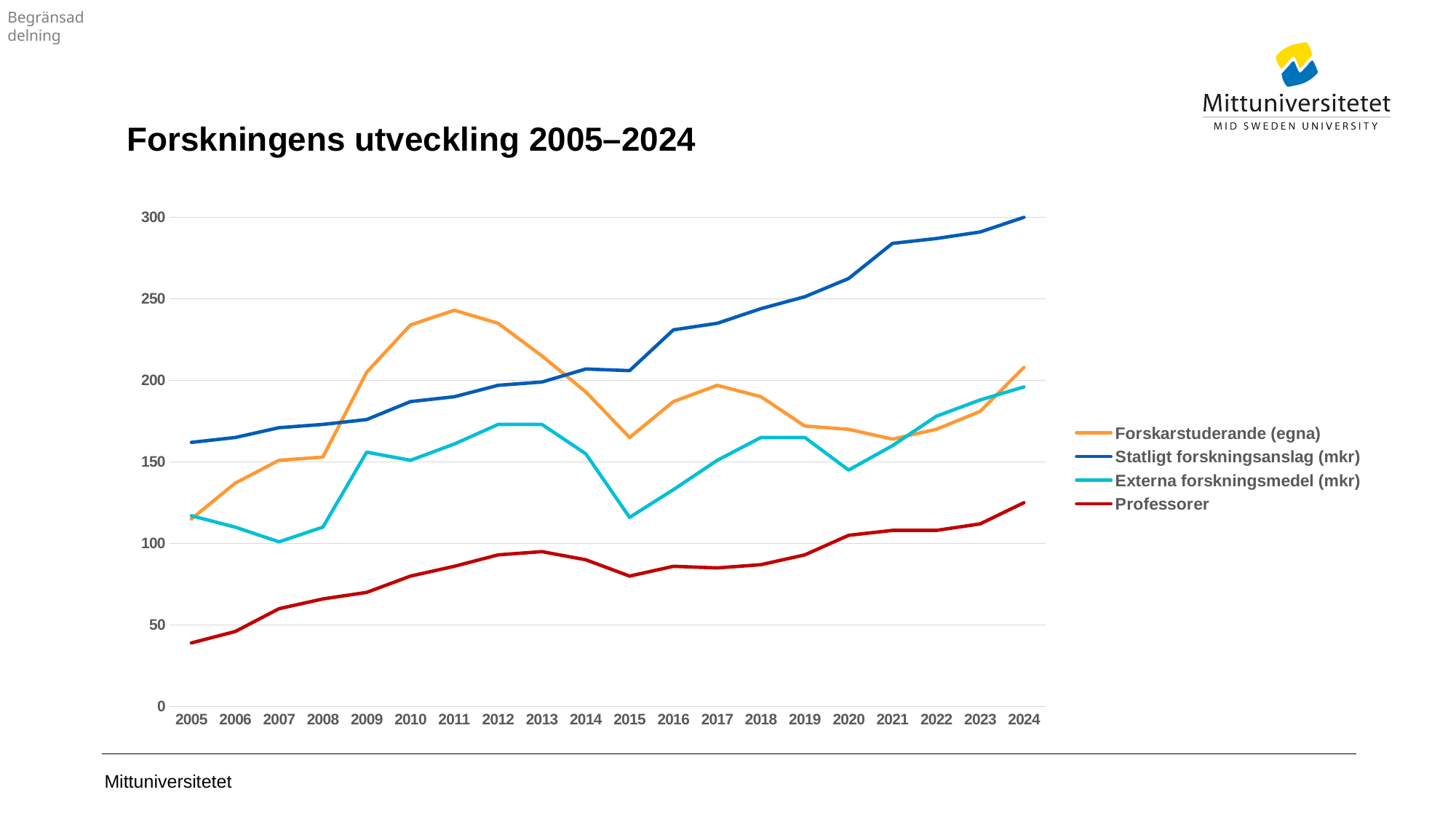
Which series is highest in 2024? Statligt forskningsanslag (mkr) Is the value for Statligt forskningsanslag (mkr) in 2021 greater or less than 250? greater In 2010, which is larger: Forskarstuderande (egna) or Statligt forskningsanslag (mkr)? Forskarstuderande (egna) Does Statligt forskningsanslag (mkr) generally rise or fall from 2005 to 2024? rise Is the value for Forskarstuderande (egna) in 2015 greater or less than 150? greater In which year does Forskarstuderande (egna) reach its highest value? 2011 Which series is lowest across the whole period? Professorer How many years are shown on the x axis? 20 What kind of chart is shown on the slide? line chart Is the value for Professorer in 2005 greater or less than 50? less What is the title of the chart? Forskningens utveckling 2005–2024 How many series does the legend list? 4